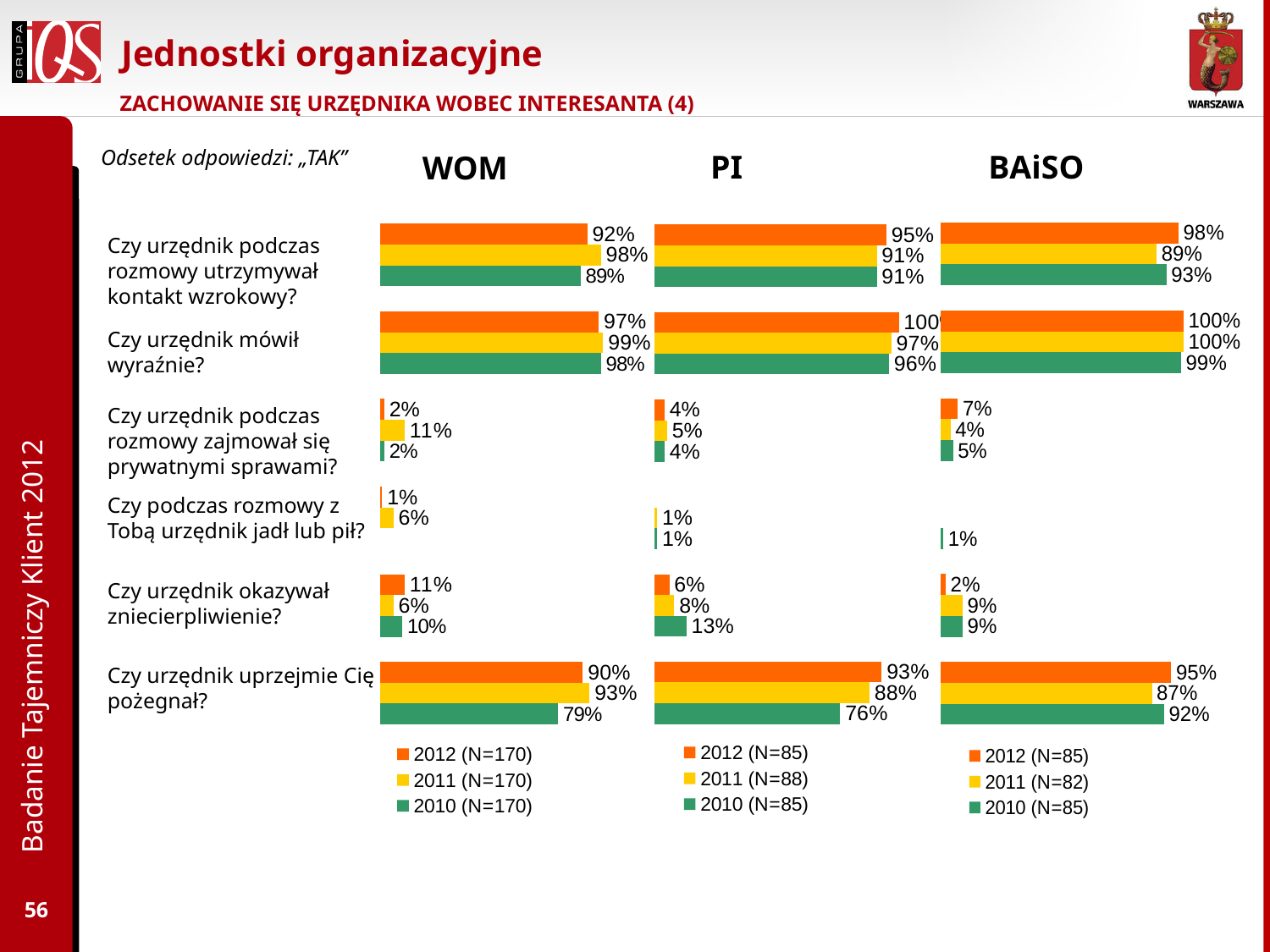
In the WOM chart, what is the difference between the 2011 and 2010 values for "Czy urzędnik uprzejmie Cię pożegnał?"? 14% In the BAiSO chart, what is the difference between the 2012 and 2011 values for "Czy urzędnik podczas rozmowy utrzymywał kontakt wzrokowy?"? 9% In the PI chart, which year has the highest value for "Czy urzędnik uprzejmie Cię pożegnał?"? 2012 What sample size (N) does the legend of the BAiSO chart give for 2011? N=82 How many series does the legend of the PI chart list? 3 In the WOM chart, is the 2011 value for "Czy urzędnik podczas rozmowy zajmował się prywatnymi sprawami?" larger or smaller than the 2012 value? larger In the WOM chart, what is the 2012 value for "Czy urzędnik podczas rozmowy utrzymywał kontakt wzrokowy?"? 92% What type of chart is the WOM chart? bar chart In the PI chart, what is the 2010 value for "Czy urzędnik okazywał zniecierpliwienie?"? 13% How many question categories are shown in the BAiSO chart? 6 In the BAiSO chart, what is the 2011 value for "Czy urzędnik uprzejmie Cię pożegnał?"? 87% In the BAiSO chart, which year has the lowest value for "Czy urzędnik okazywał zniecierpliwienie?"? 2012